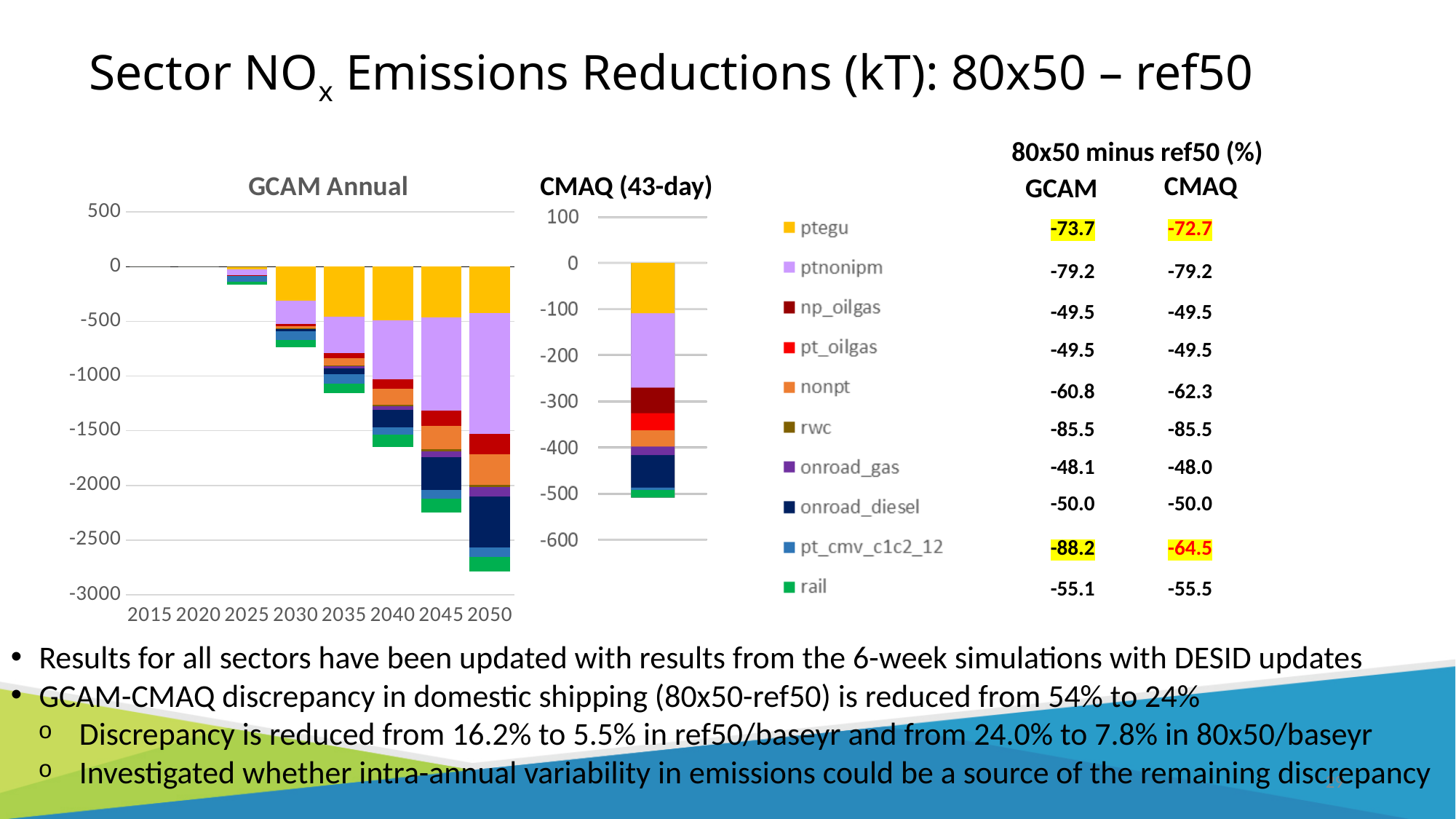
In the GCAM Annual chart, how many years have a visible stacked bar? 6 In the GCAM Annual chart, which series has the largest segment in the 2050 bar? ptnonipm How many series does the legend list for the charts? 10 In the GCAM Annual chart, is the stacked total for 2030 greater or less than -500? less What kind of chart is the GCAM Annual chart? stacked bar chart Which series is shown in yellow in the legend? ptegu In the GCAM Annual chart, is the stacked total for 2045 greater or less than -2000? less In the GCAM Annual chart, do the stacked totals rise or fall from 2025 to 2050? fall In the GCAM Annual chart, is the stacked total for 2025 greater or less than -500? greater